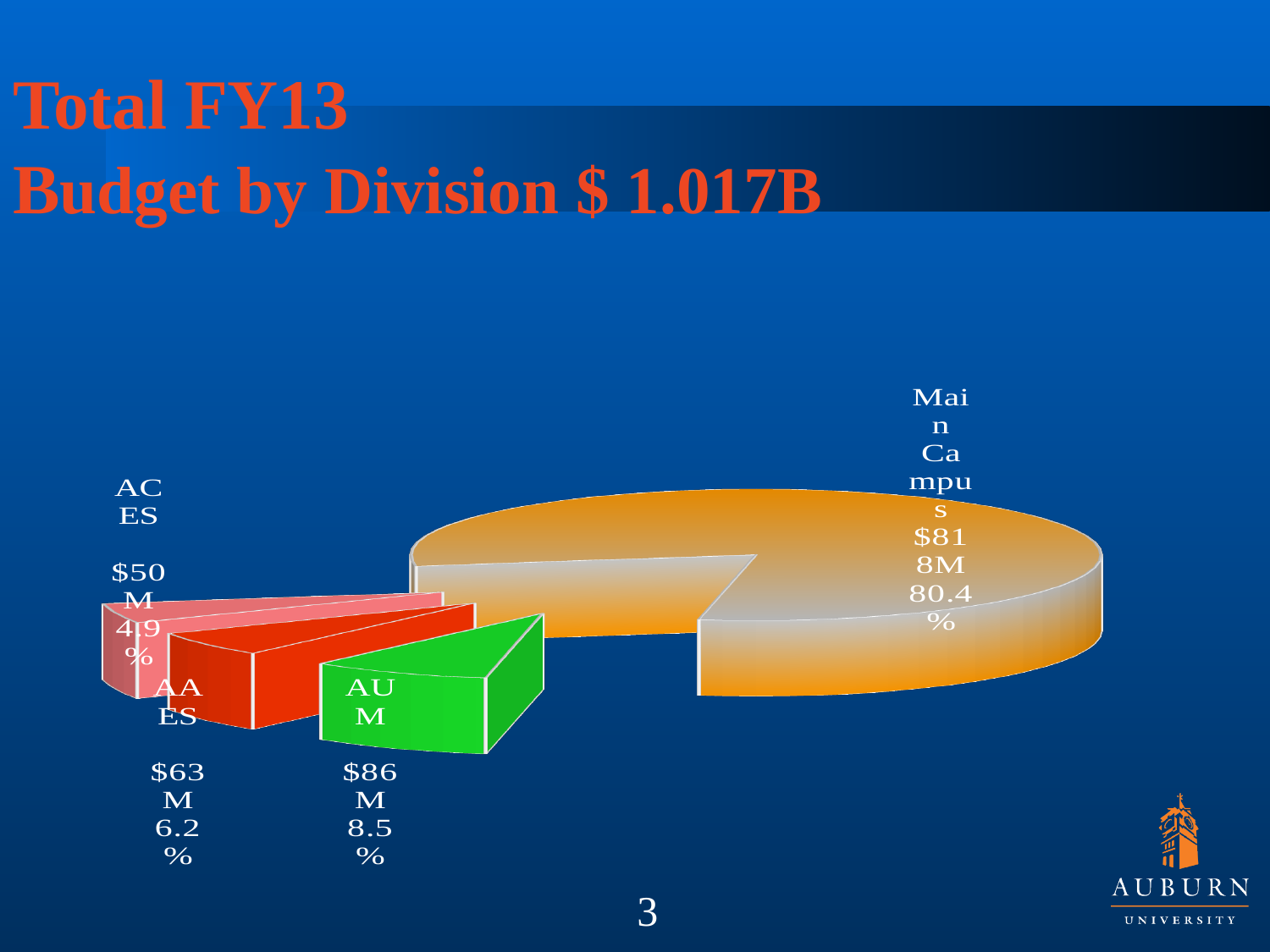
What is the difference in budget between AUM and ACES? $36M What is the budget amount for AAES? $63M What percentage of the budget does AUM represent? 8.5% Which is larger, the budget for AUM or the budget for AAES? AUM What percentage of the budget does Main Campus represent? 80.4% What kind of chart is shown on the slide? Pie chart What percentage of the budget does ACES represent? 4.9% What total budget figure is given in the slide title? $ 1.017B What is the budget amount for Main Campus? $818M Which division has the smallest share of the budget? ACES Which division has the largest share of the budget? Main Campus How many divisions are shown in the pie chart? 4